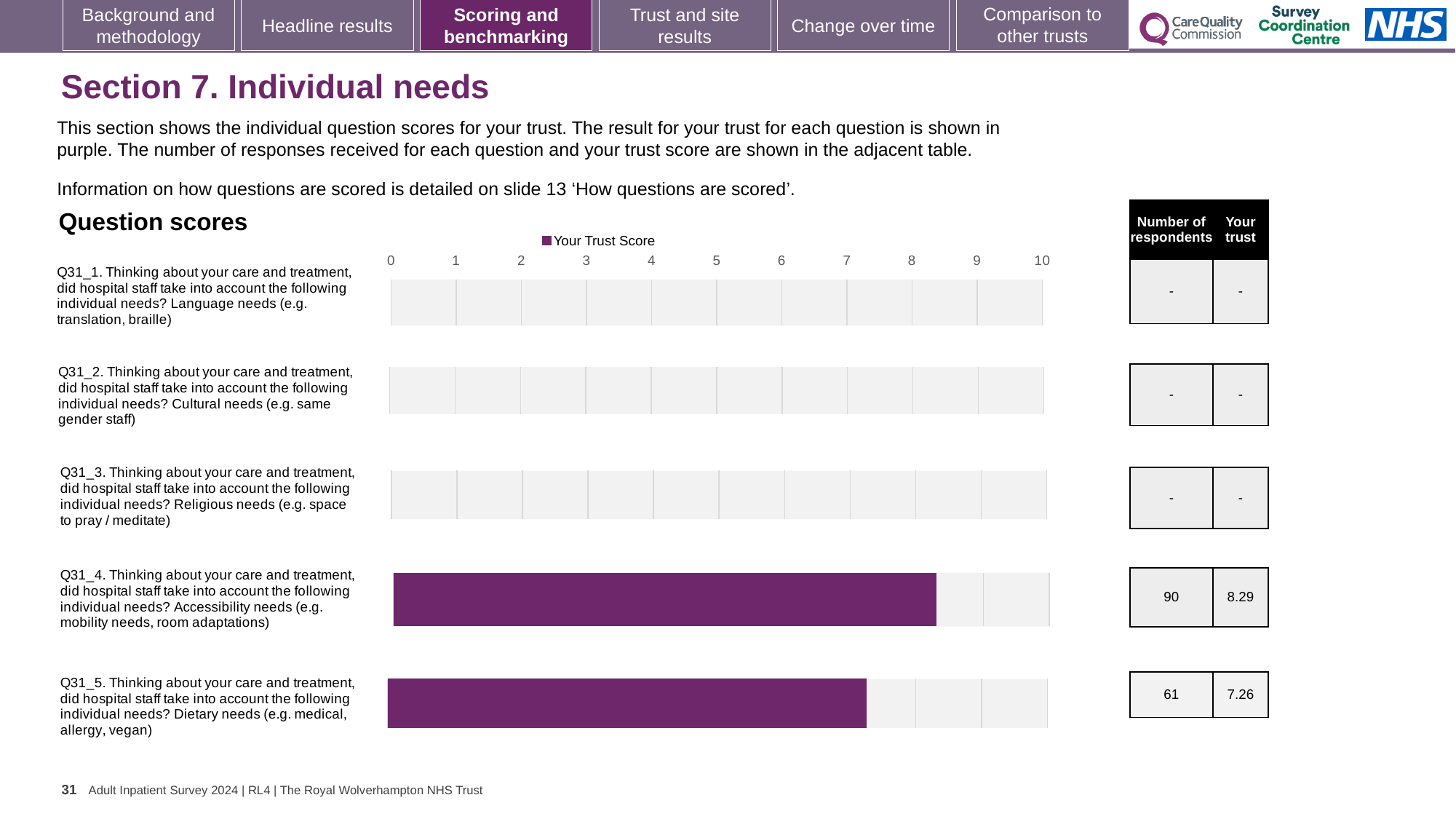
How many respondents answered Q31_5 (Dietary needs)? 61 What is the name of the series shown in the chart legend? Your Trust Score How many respondents answered Q31_4 (Accessibility needs)? 90 How many questions are listed in the Question scores chart? 5 Is the trust score for Q31_5 (Dietary needs) greater or less than 8? less What is the trust score for Q31_5 (Dietary needs)? 7.26 Is the trust score for Q31_4 (Accessibility needs) greater or less than 8? greater What is the trust score for Q31_4 (Accessibility needs)? 8.29 What type of chart is used to show the question scores? Bar chart Which question has the higher trust score, Q31_4 (Accessibility needs) or Q31_5 (Dietary needs)? Q31_4 (Accessibility needs) How many series does the chart legend list? 1 What is the difference between the trust scores for Q31_4 (Accessibility needs) and Q31_5 (Dietary needs)? 1.03